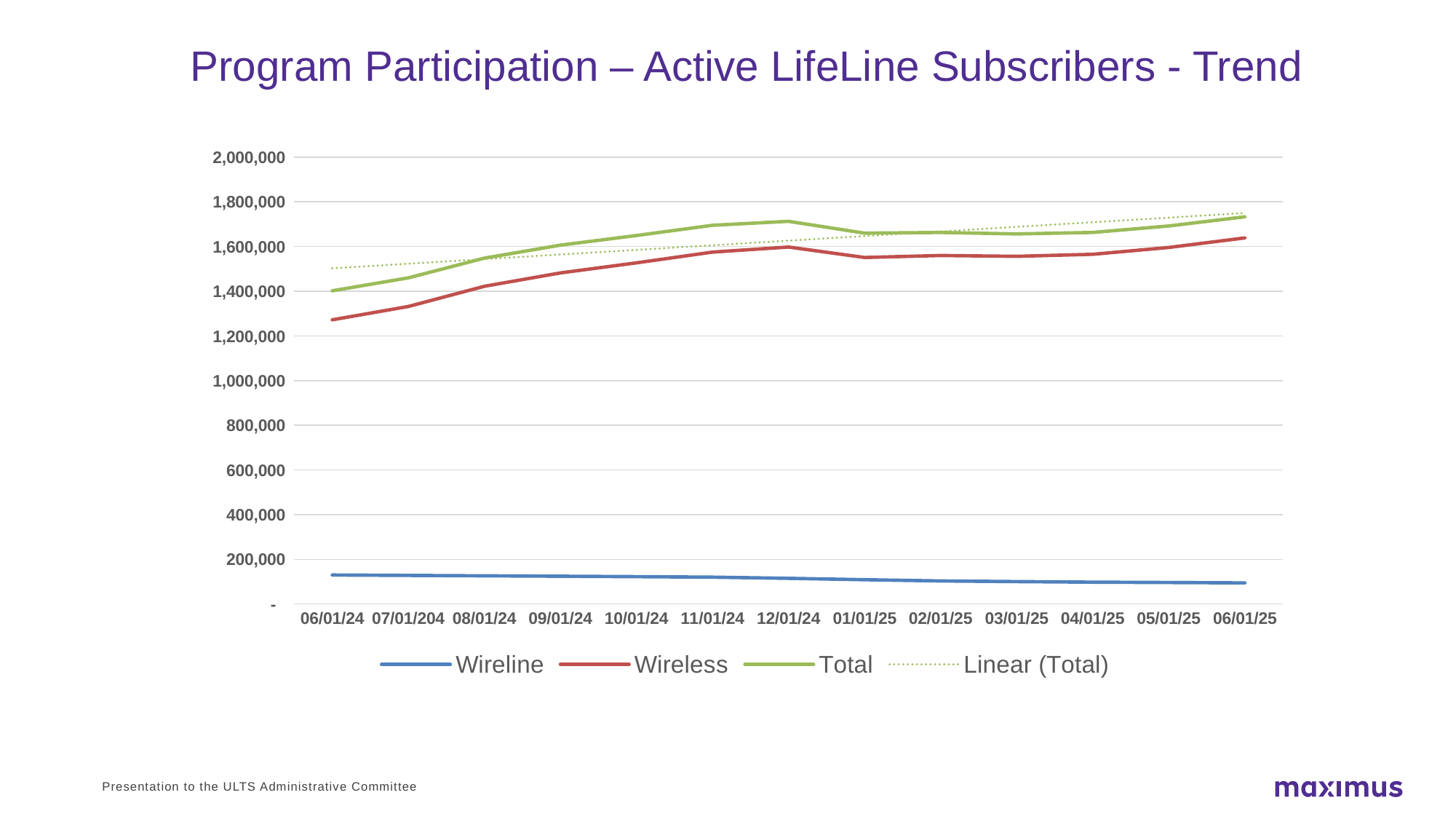
Which series is larger at 06/01/25, Wireless or Wireline? Wireless At which date is the Wireless series lowest? 06/01/24 Is the Total value at 12/01/24 greater or less than 1,600,000? greater Is the Wireless value at 06/01/24 greater or less than 1,200,000? greater How many series does the legend list? 4 Does the Wireline series rise or fall from 06/01/24 to 06/01/25? fall Is the Wireline value at 06/01/24 greater or less than 200,000? less Does the Wireless series rise or fall overall from 06/01/24 to 06/01/25? rise What is the title of the chart? Program Participation – Active LifeLine Subscribers - Trend What kind of chart is shown on the slide? line chart How many dates are plotted along the x axis? 13